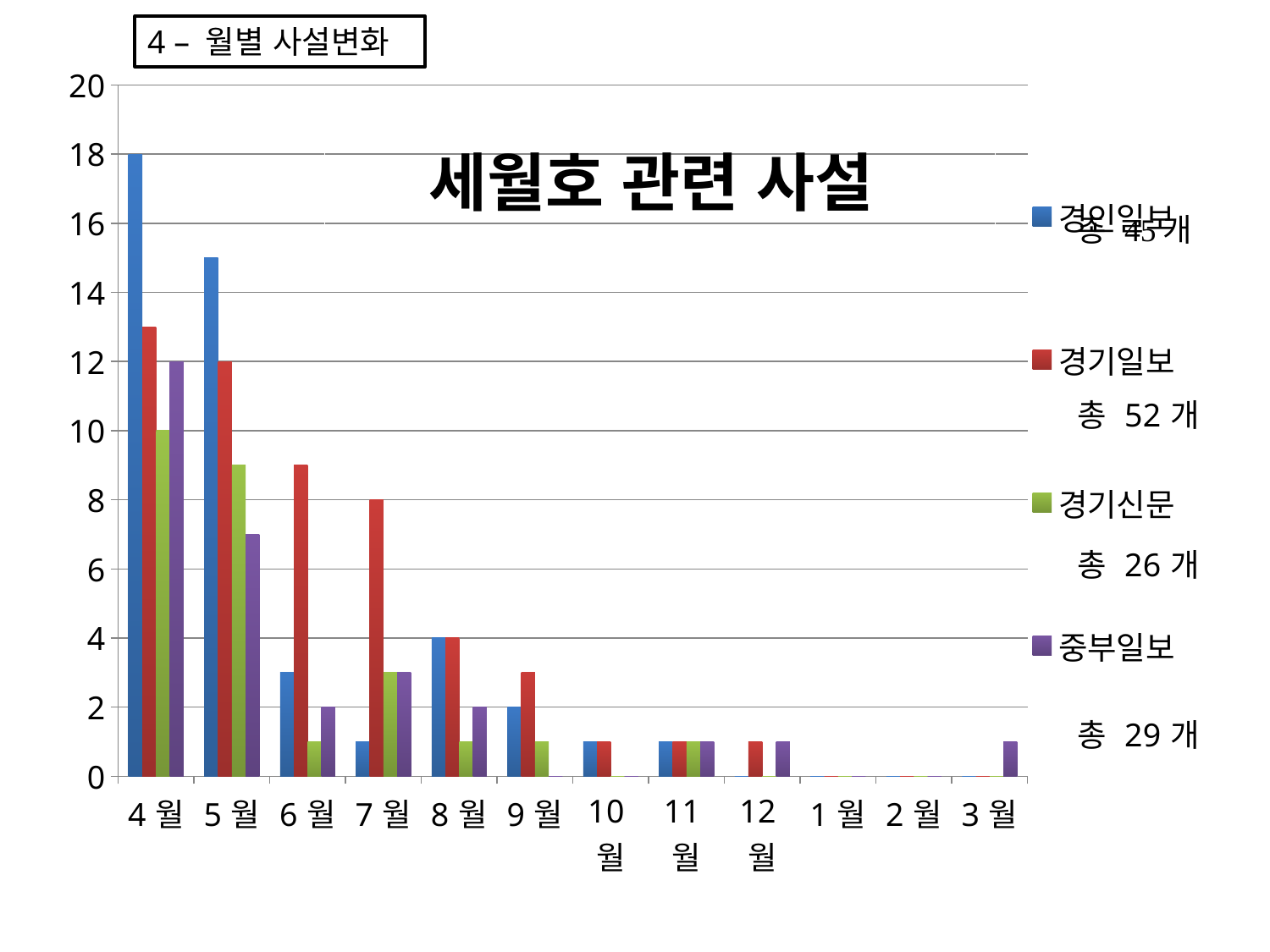
How many series does the legend list? 4 What is the difference between 경인일보 and 중부일보 in 4월? 6 What is the value for 경인일보 in 4월? 18 In which month is the value for 경인일보 highest? 4월 What is the title of the chart? 세월호 관련 사설 What is the value for 경기일보 in 5월? 12 What is the value for 중부일보 in 4월? 12 What kind of chart is shown on the slide? bar chart Is the value for 경기일보 in 4월 greater or less than 12? greater How many months are shown on the x axis? 12 Which is larger in 4월, 경인일보 or 경기일보? 경인일보 What is the value for 경기신문 in 4월? 10